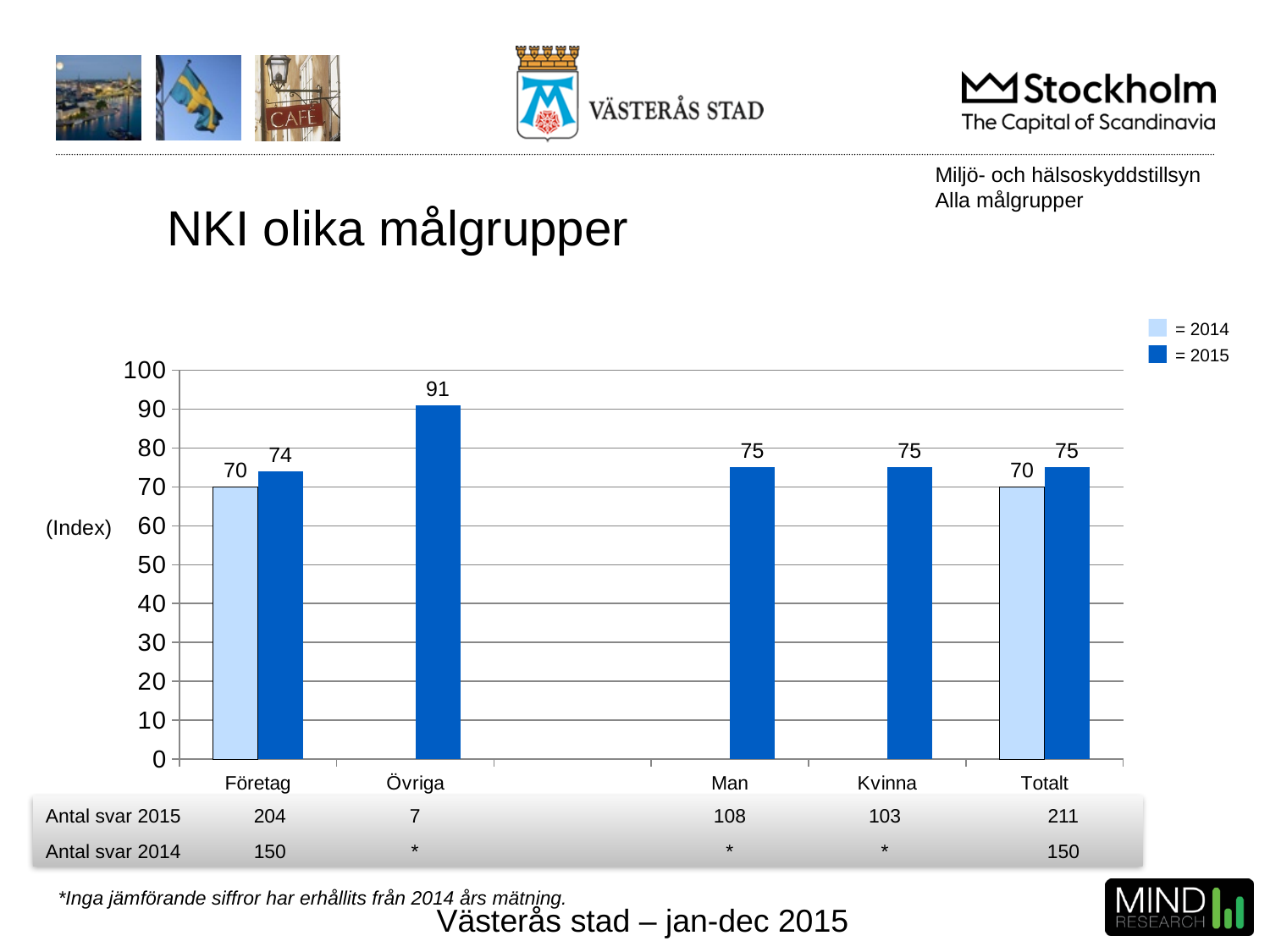
How many series does the legend list? 2 What is the 2015 NKI value for Totalt? 75 What is the 2015 NKI value for Övriga? 91 How many categories are shown on the x axis of the chart? 5 What is the difference between the 2015 NKI values for Övriga and Man? 16 What is the difference between the 2015 and 2014 NKI values for Företag? 4 What is the 2014 NKI value for Företag? 70 What kind of chart is shown on the slide? Bar chart Which category has the lowest 2015 NKI value? Företag Which category has the highest 2015 NKI value? Övriga Is the 2015 NKI value for Övriga greater or less than 90? greater Which is larger: the 2015 NKI value for Övriga or for Kvinna? Övriga